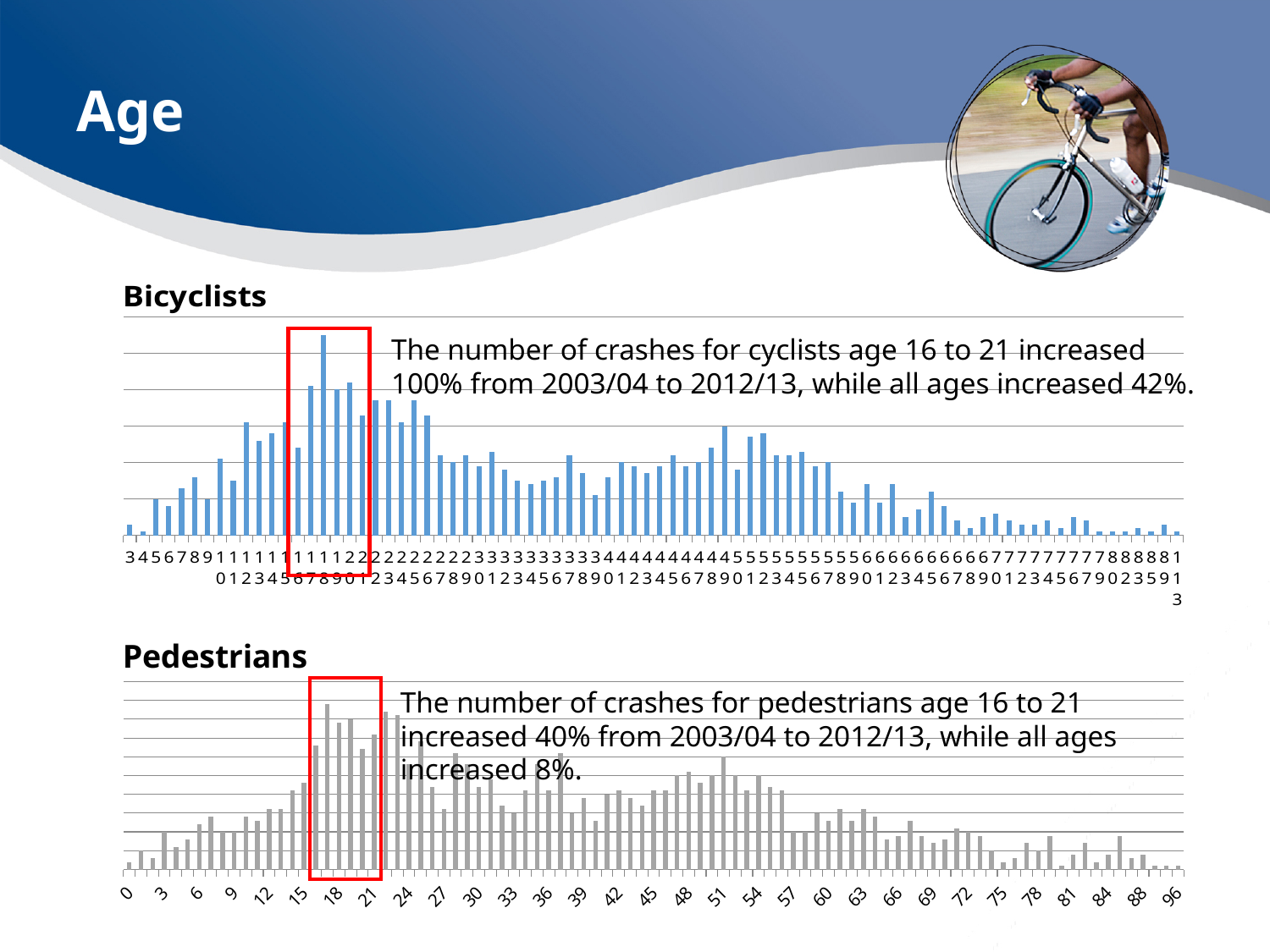
What colour are the bars in the Pedestrians chart? gray In the Bicyclists chart, is the bar for age 18 taller or shorter than the bar for age 50? taller What kind of chart is the Bicyclists chart? bar chart In the Bicyclists chart, which age has the tallest bar? 18 In the Pedestrians chart, which has the larger value, age 51 or age 75? age 51 In the Bicyclists chart, do the values generally rise or fall from age 3 to age 18? rise In the Pedestrians chart, do the values generally rise or fall from age 57 to age 96? fall Which age range is highlighted by the red box on both charts? 16 to 21 In the Pedestrians chart, which has the larger value, age 0 or age 18? age 18 What kind of chart is the Pedestrians chart? bar chart In the Bicyclists chart, do the values generally rise or fall from age 60 to age 90? fall